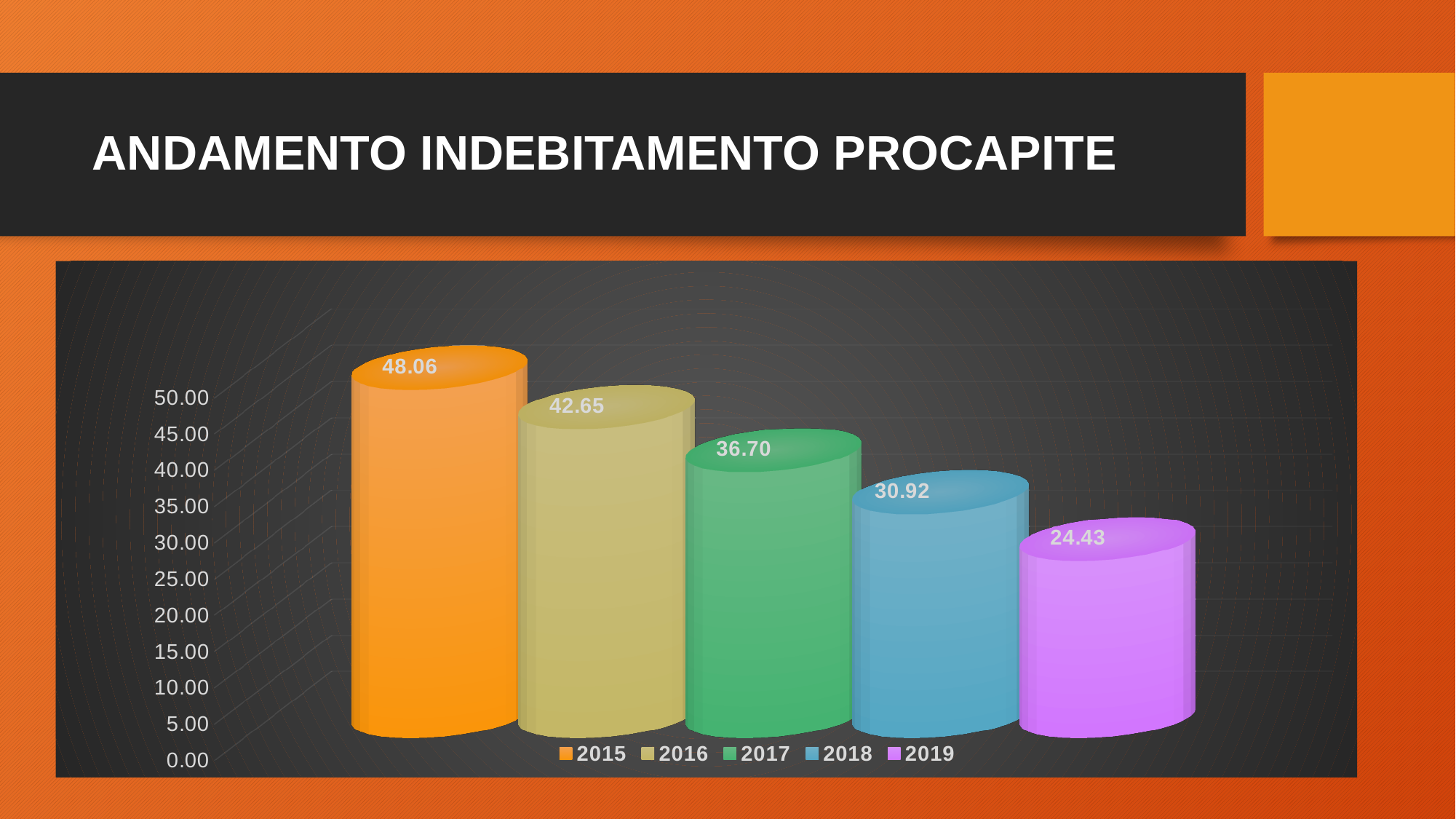
What is the value for 2017? 36.70 What is the value for 2015? 48.06 What is the value for 2019? 24.43 Which year has the lowest value? 2019 What is the difference between the values for 2016 and 2018? 11.73 Do the values rise or fall from 2015 to 2019? fall What is the difference between the values for 2015 and 2019? 23.63 Is the value for 2018 greater or less than 35.00? less Which is larger, the value for 2016 or the value for 2018? 2016 How many years are shown in the chart? 5 Which year has the highest value? 2015 What kind of chart is shown on the slide? bar chart